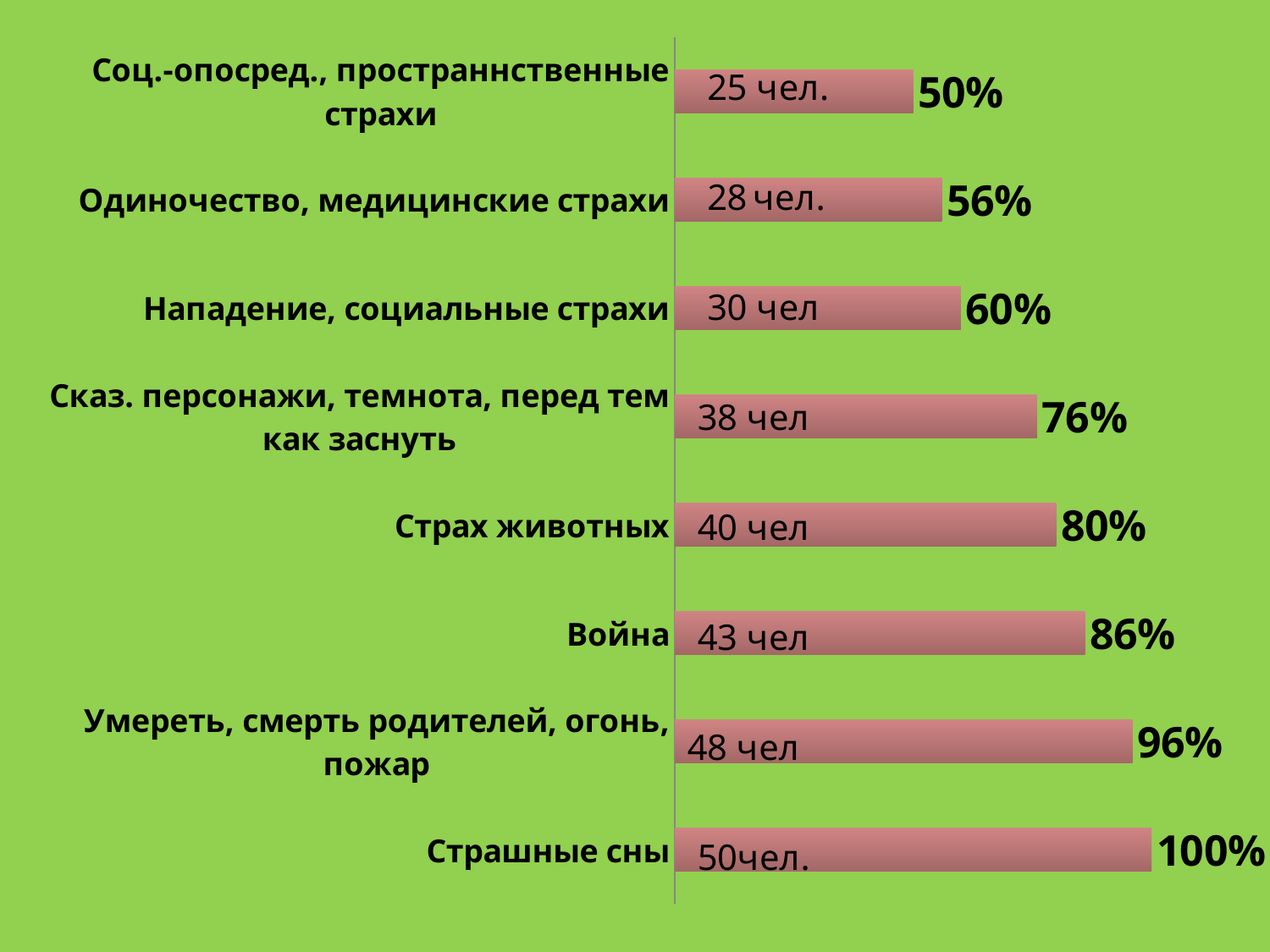
What colour are the bars in the chart? Reddish-brown (pink-red) What percentage is shown for «Одиночество, медицинские страхи»? 56% What is the difference in number of people between «Страшные сны» and «Соц.-опосред., пространнственные страхи»? 25 What percentage is shown for «Война»? 86% Which category has the lowest percentage? Соц.-опосред., пространнственные страхи What percentage is shown for «Страшные сны»? 100% How many people are shown for «Страх животных»? 40 чел Which has a higher percentage: «Сказ. персонажи, темнота, перед тем как заснуть» or «Война»? Война What kind of chart is shown on the slide? Bar chart Which category has the highest percentage? Страшные сны What is the difference in percentage points between «Умереть, смерть родителей, огонь, пожар» and «Нападение, социальные страхи»? 36 How many categories are shown in the chart? 8